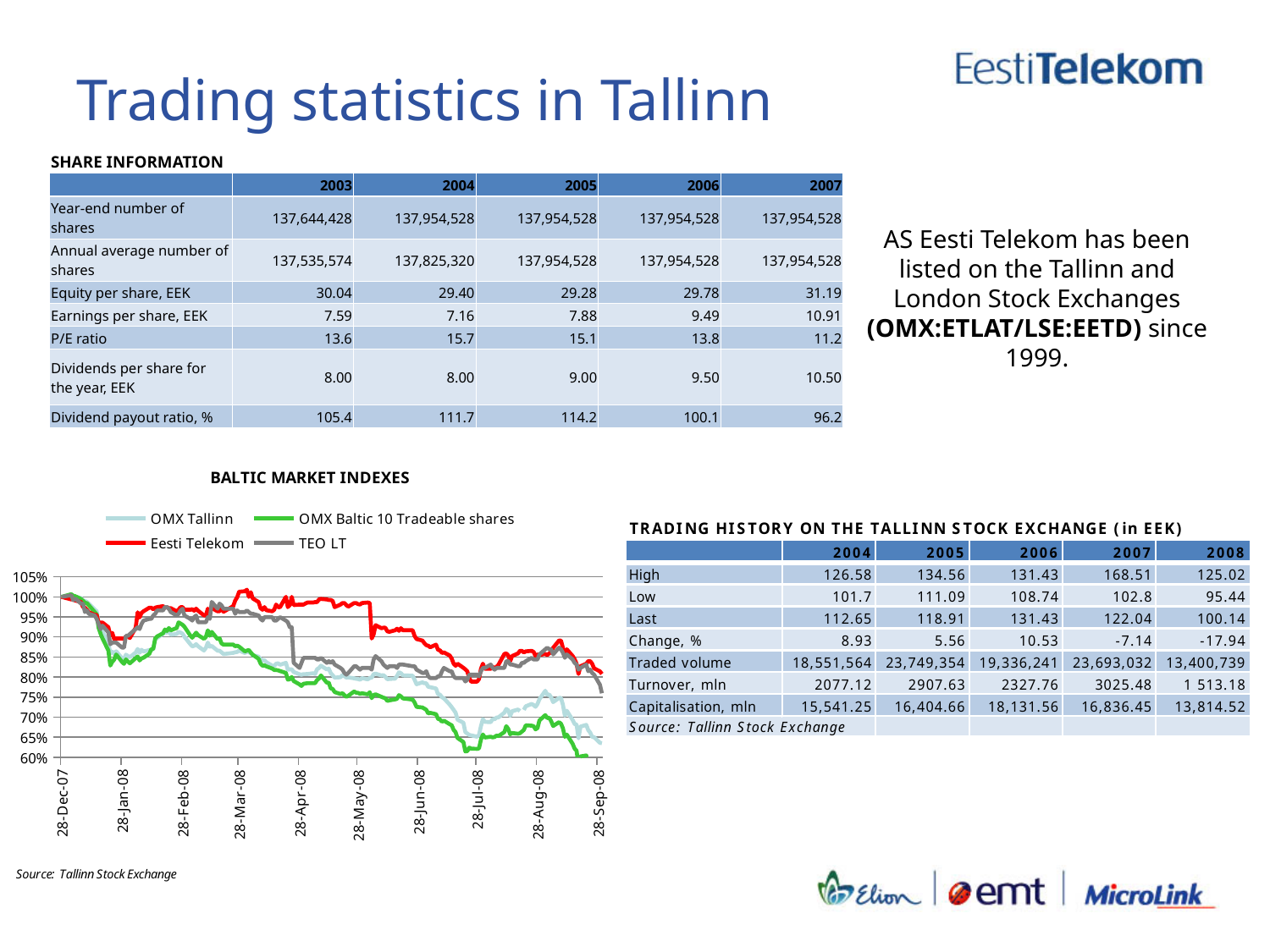
How many series does the legend of the BALTIC MARKET INDEXES chart list? 4 In the BALTIC MARKET INDEXES chart, which series has the lowest value at 28-Sep-08? OMX Baltic 10 Tradeable shares In the BALTIC MARKET INDEXES chart, at 28-Sep-08 which is larger: Eesti Telekom or OMX Baltic 10 Tradeable shares? Eesti Telekom Overall, do the index values in the BALTIC MARKET INDEXES chart rise or fall from 28-Dec-07 to 28-Sep-08? fall In the BALTIC MARKET INDEXES chart, is the value for OMX Tallinn at 28-Sep-08 greater or less than 75%? less What source is cited below the BALTIC MARKET INDEXES chart? Tallinn Stock Exchange In the BALTIC MARKET INDEXES chart, is the value for OMX Baltic 10 Tradeable shares at 28-Sep-08 greater or less than 65%? less What colour is the Eesti Telekom line in the BALTIC MARKET INDEXES chart? red At 28-Dec-07, what value do all the series in the BALTIC MARKET INDEXES chart start at? 100% How many date labels are shown on the x axis of the BALTIC MARKET INDEXES chart? 10 What kind of chart is the BALTIC MARKET INDEXES chart? line chart In the BALTIC MARKET INDEXES chart, is the value for Eesti Telekom at 28-Sep-08 greater or less than 75%? greater